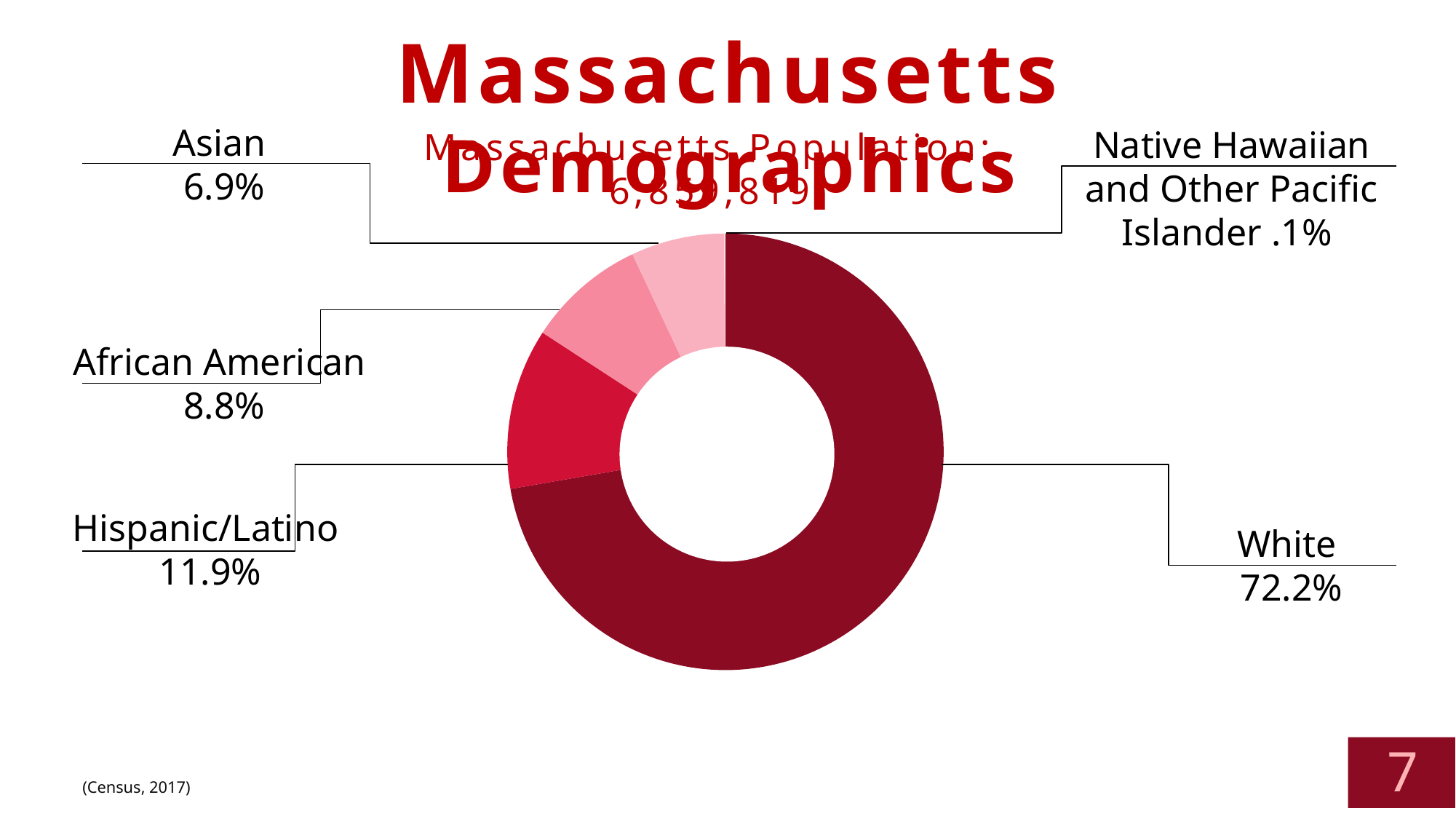
What percentage of the Massachusetts population is White according to the chart? 72.2% What percentage of the Massachusetts population is Hispanic/Latino? 11.9% Which group has the largest share of the Massachusetts population in the chart? White What is the difference in percentage points between the Hispanic/Latino share and the Asian share? 5.0 What kind of chart is shown on the slide? Doughnut (pie) chart What percentage of the Massachusetts population is African American? 8.8% Which group has the smallest share of the Massachusetts population in the chart? Native Hawaiian and Other Pacific Islander What is the difference in percentage points between the White share and the Hispanic/Latino share? 60.3 Which group has a larger share, African American or Asian? African American What percentage is shown for Native Hawaiian and Other Pacific Islander? .1% How many population groups are labeled on the chart? 5 What percentage of the Massachusetts population is Asian? 6.9%